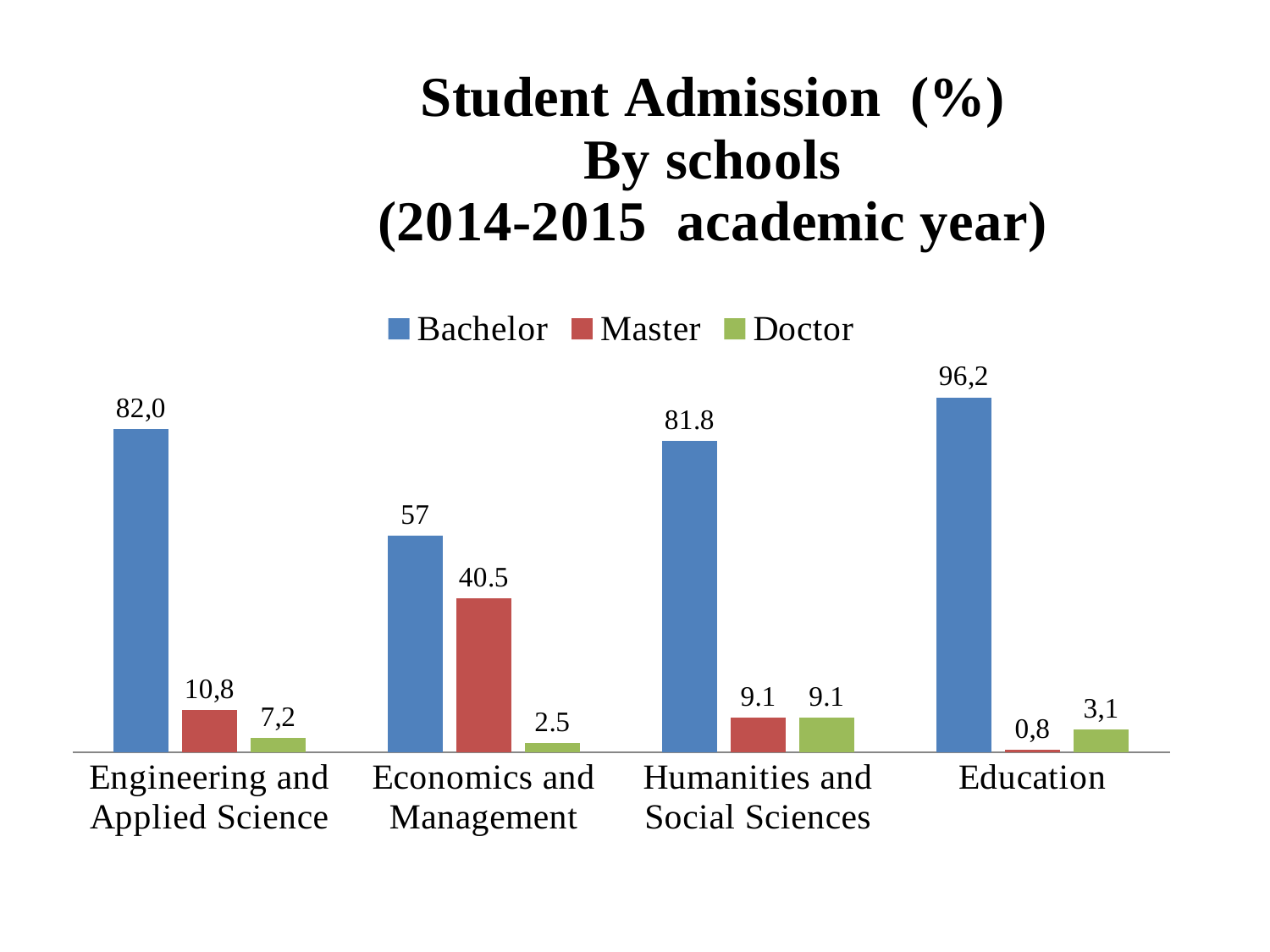
Which is larger, the Master value for Economics and Management or the Master value for Engineering and Applied Science? Economics and Management Which school has the highest Doctor value? Humanities and Social Sciences What is the Master value for Education? 0,8 What is the Master value for Economics and Management? 40.5 What is the Bachelor value for Education? 96,2 What is the Doctor value for Engineering and Applied Science? 7,2 What is the difference between the Bachelor and Master values for Economics and Management? 16.5 What kind of chart is shown on the slide? Bar chart Which school has the lowest Master value? Education Which school has the highest Bachelor value? Education How many series does the legend list? 3 How many schools are shown on the x axis? 4